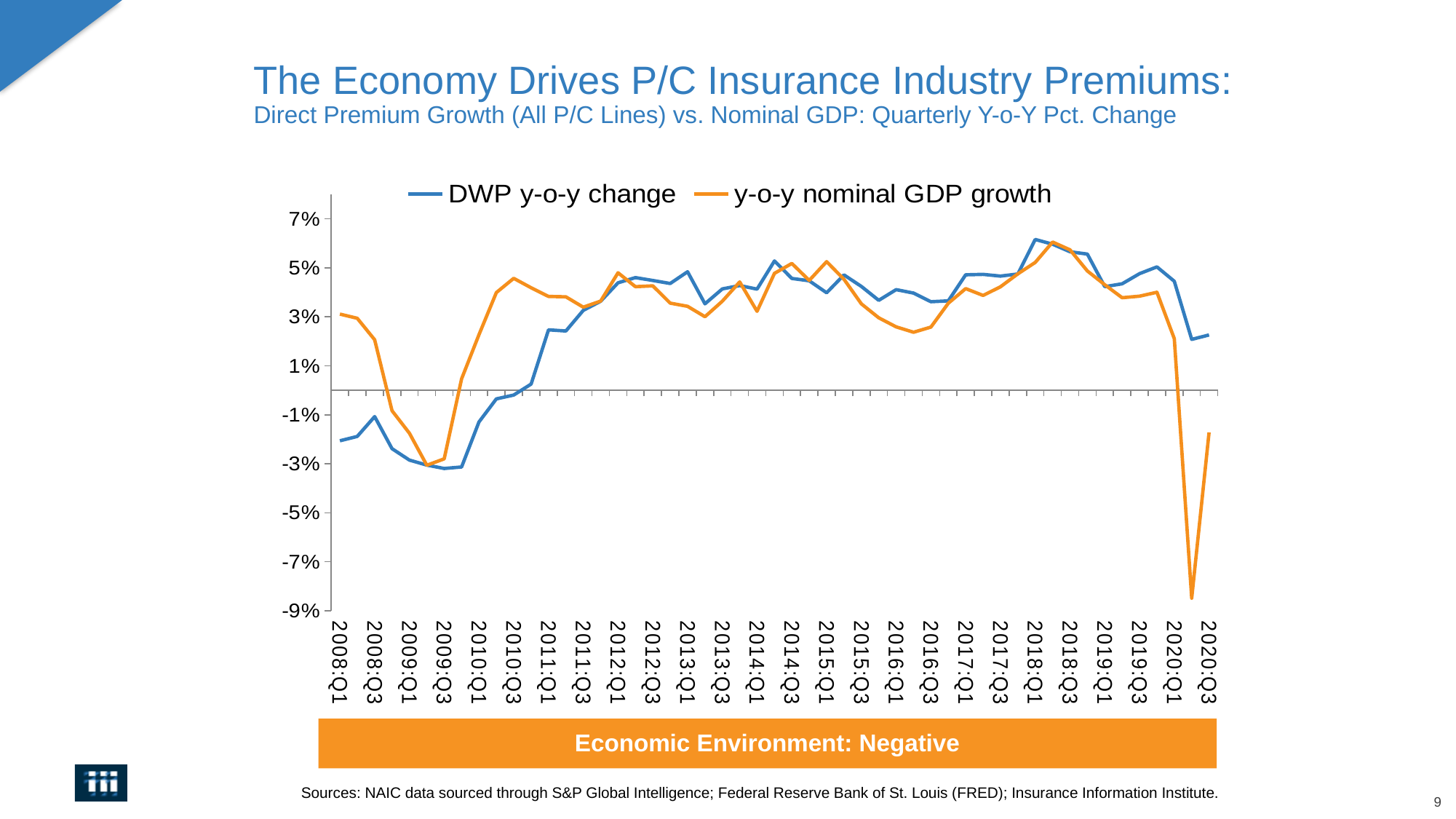
Is the lowest value of the y-o-y nominal GDP growth line greater or less than -7%? less What colour is the line for y-o-y nominal GDP growth? Orange Is the DWP y-o-y change value at 2020:Q3 greater or less than 1%? greater At 2010:Q3, which series has the higher value, DWP y-o-y change or y-o-y nominal GDP growth? y-o-y nominal GDP growth Does the DWP y-o-y change line rise or fall between 2009:Q3 and 2011:Q3? Rise What are the two series named in the legend? DWP y-o-y change; y-o-y nominal GDP growth Is the y-o-y nominal GDP growth value at 2020:Q3 greater or less than -1%? less What kind of chart is shown on the slide? Line chart How many series does the chart's legend list? 2 At 2018:Q1, which series has the higher value, DWP y-o-y change or y-o-y nominal GDP growth? DWP y-o-y change